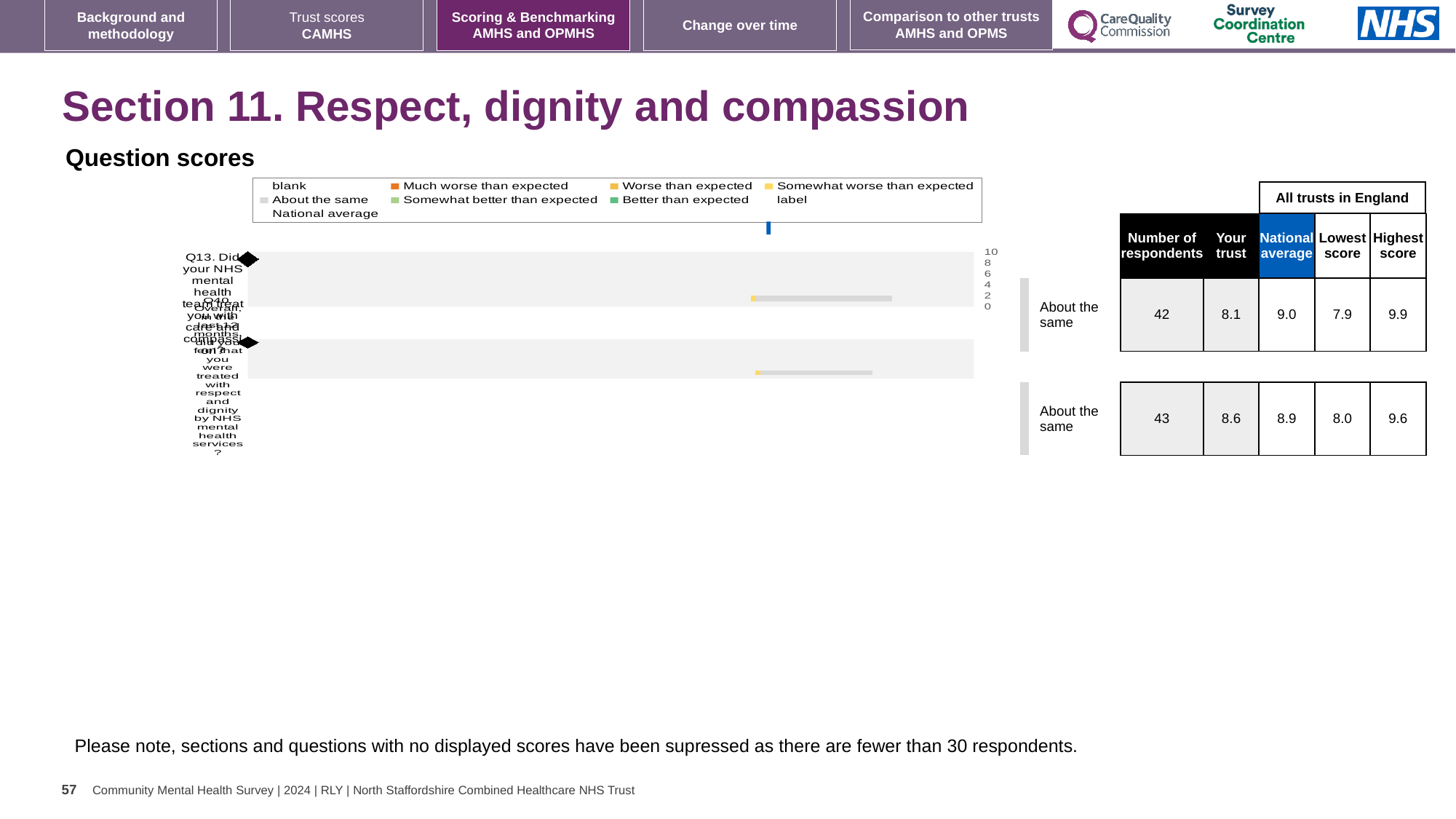
In the Question scores chart, what is the 'Your trust' score for the top row? 8.1 In the Question scores chart, what is the 'Your trust' score for the bottom row? 8.6 In the Question scores chart, what is the highest score for the bottom row? 9.6 In the Question scores chart, what is the national average for the top row? 9.0 In the Question scores chart, which row has the higher 'Your trust' score, the top row or the bottom row? bottom row In the Question scores chart, what is the lowest score for the bottom row? 8.0 What kind of chart is shown under 'Question scores'? bar chart How many question rows are plotted in the Question scores chart? 2 In the Question scores chart, what is the number of respondents for the top row? 42 In the Question scores chart, what is the difference between the highest and lowest scores for the bottom row? 1.6 In the Question scores chart, what is the difference between the national average and the 'Your trust' score for the top row? 0.9 In the Question scores chart, what benchmark category is shown for both rows? About the same